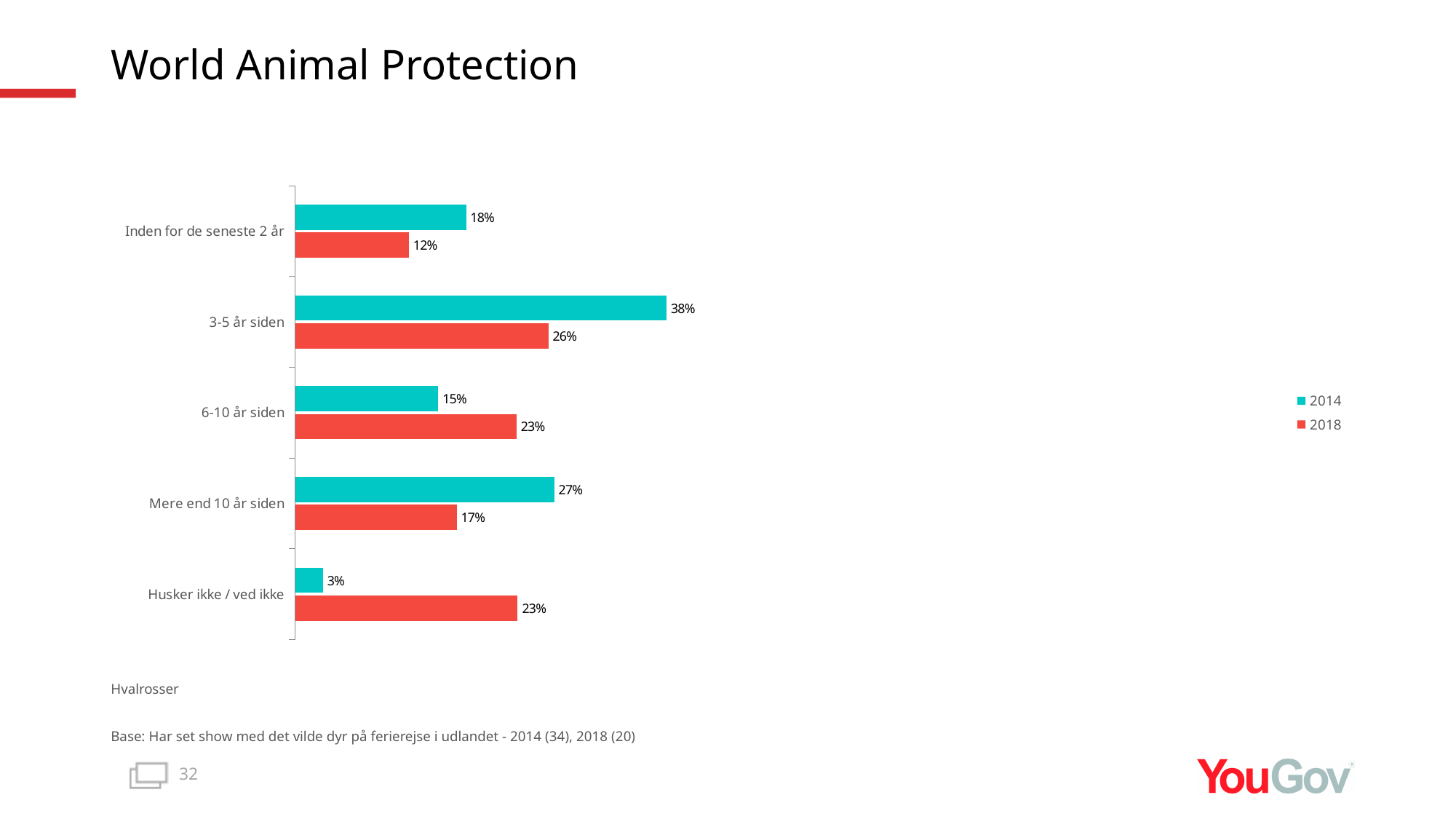
How many series does the legend list? 2 What is the 2018 value for "Inden for de seneste 2 år"? 12% What is the 2018 value for "Husker ikke / ved ikke"? 23% How many categories are shown on the chart? 5 What is the 2014 value for "3-5 år siden"? 38% For "6-10 år siden", which year has the larger value, 2014 or 2018? 2018 What is the difference between the 2014 and 2018 values for "3-5 år siden"? 12 percentage points Which category has the lowest 2014 value? Husker ikke / ved ikke Which category has the highest 2014 value? 3-5 år siden Which category has the lowest 2018 value? Inden for de seneste 2 år Which colour represents the 2018 series? Red What kind of chart is shown on the slide? Bar chart